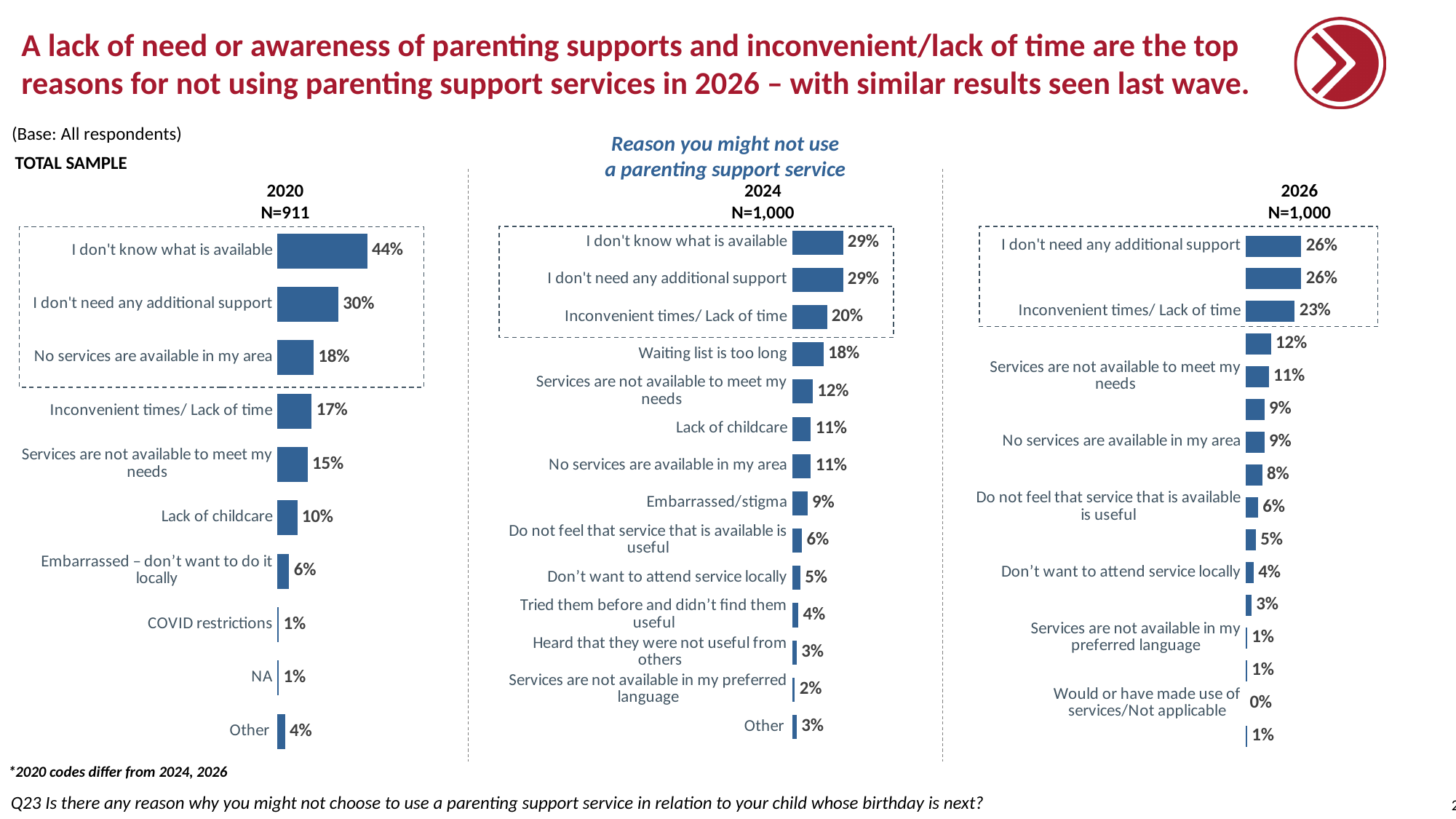
In the 2020 chart, which reason has the highest percentage? I don't know what is available In the 2020 chart, what is the difference in percentage points between "I don't know what is available" and "I don't need any additional support"? 14 percentage points In the 2024 chart, what is the value for "Waiting list is too long"? 18% In the 2024 chart, which is larger: "Inconvenient times/ Lack of time" or "Waiting list is too long"? Inconvenient times/ Lack of time In the 2026 chart, what is the difference in percentage points between "I don't need any additional support" and "Inconvenient times/ Lack of time"? 3 percentage points What is the sample size (N) shown for the 2020 chart? N=911 In the 2024 chart, what is the value for "Lack of childcare"? 11% In the 2020 chart, what percentage of respondents said "I don't know what is available"? 44% What type of chart is used to show the 2024 results? Bar chart In the 2026 chart, what is the value for "Inconvenient times/ Lack of time"? 23% How many reasons are shown in the 2020 chart? 10 In the 2024 chart, which labelled reason has the lowest percentage? Services are not available in my preferred language